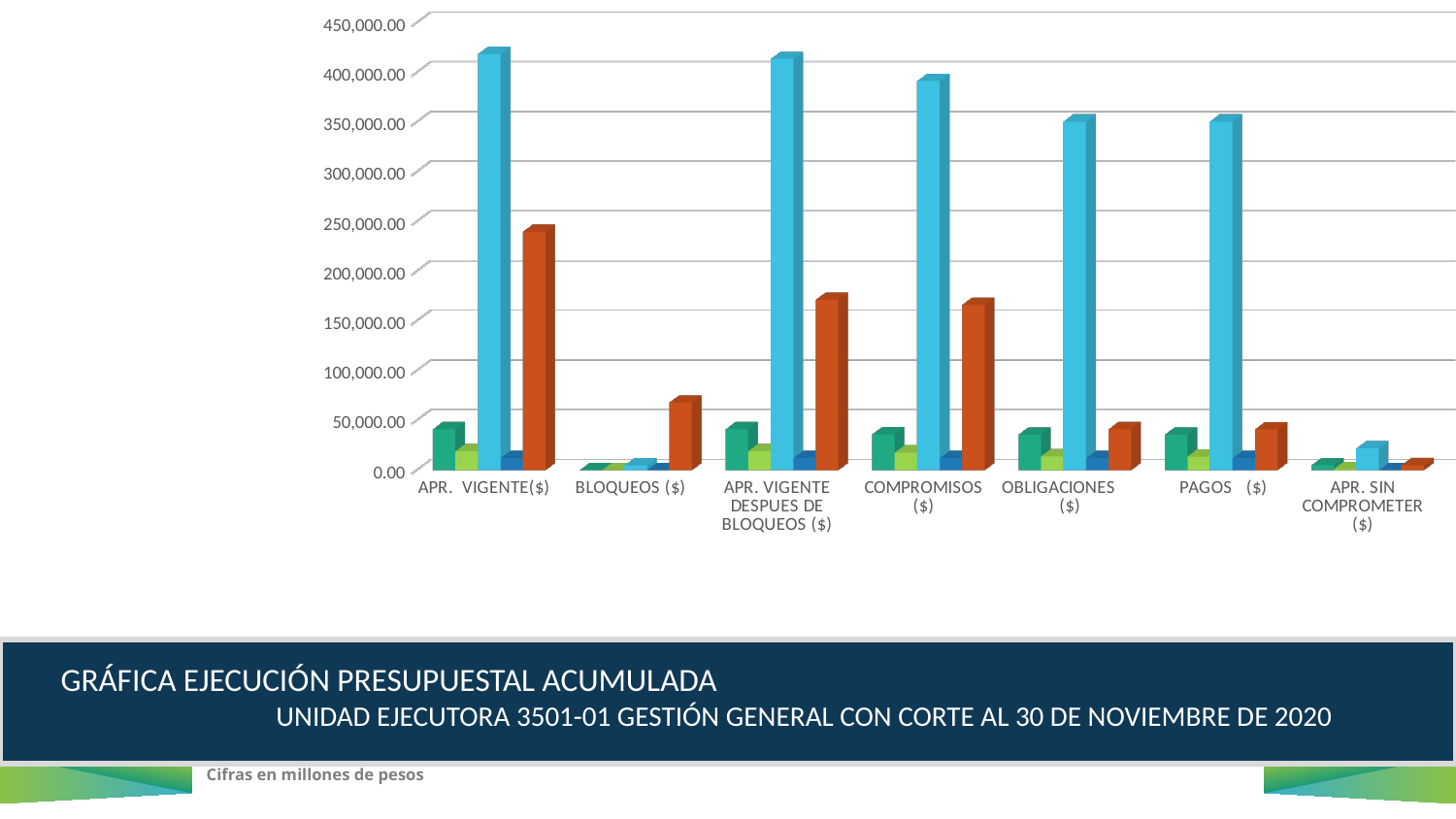
Is the orange bar for BLOQUEOS ($) greater or less than 50,000.00? greater Is the light blue bar for APR. VIGENTE($) greater or less than 400,000.00? greater How many categories are shown along the x axis of the chart? 7 Which has the larger orange bar, APR. VIGENTE($) or COMPROMISOS ($)? APR. VIGENTE($) Is the orange bar for APR. VIGENTE($) greater or less than 200,000.00? greater What is the highest value shown on the vertical axis of the chart? 450,000.00 Which has the larger light blue bar, COMPROMISOS ($) or PAGOS ($)? COMPROMISOS ($) Which category has the shortest light blue bar? BLOQUEOS ($) Which category has the tallest light blue bar? APR. VIGENTE($) What kind of chart is shown on the slide? bar chart